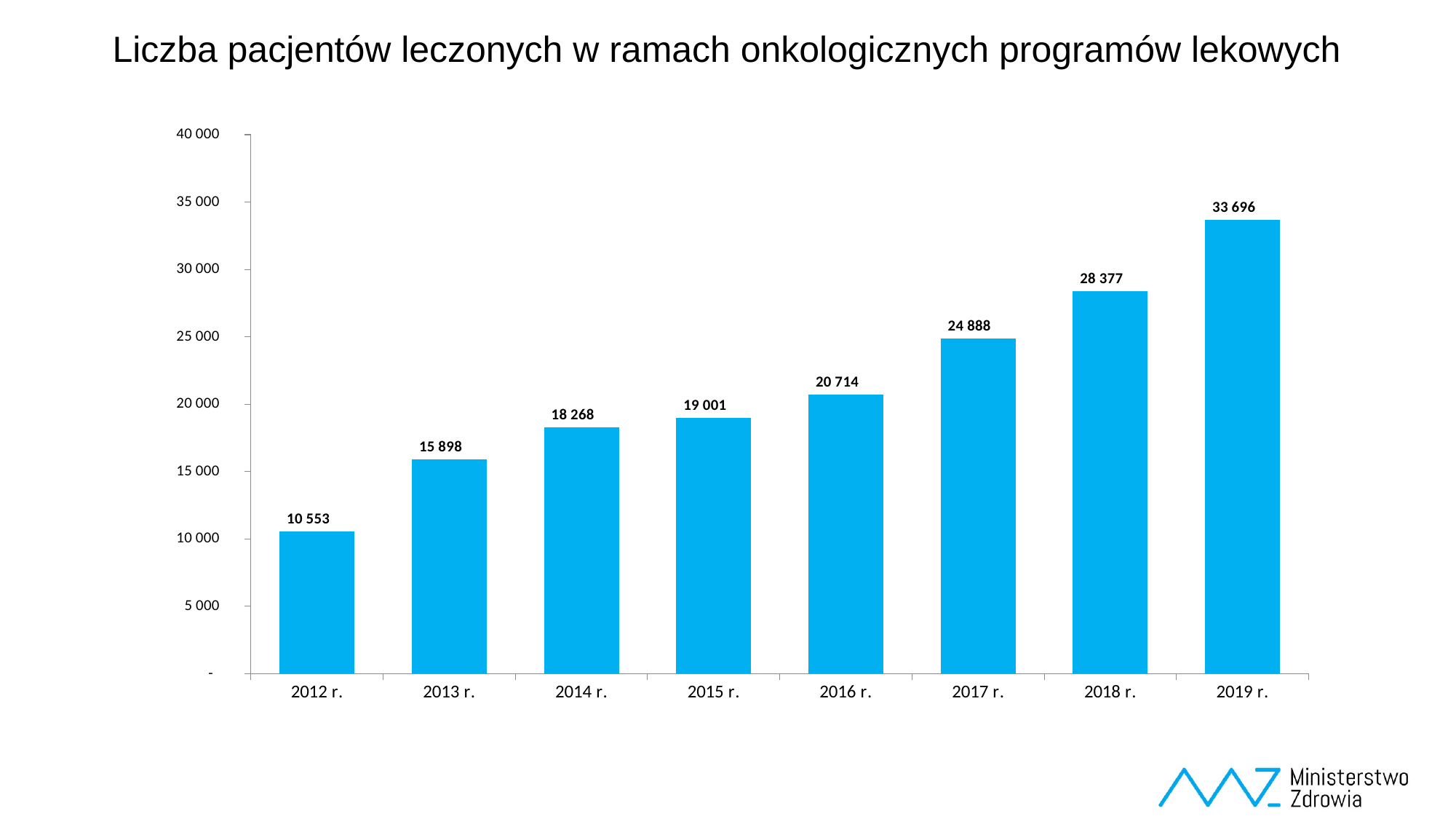
Which is larger, the value for 2015 r. or the value for 2017 r.? 2017 r. What is the difference between the values for 2019 r. and 2018 r.? 5 319 What is the value for 2019 r.? 33 696 What is the value for 2012 r.? 10 553 What is the value for 2016 r.? 20 714 What kind of chart is shown on the slide? bar chart Do the values rise or fall from 2012 r. to 2019 r.? rise How many years are shown on the x axis? 8 Which year has the highest value? 2019 r. Is the value for 2018 r. greater or less than 25 000? greater Which year has the lowest value? 2012 r. What is the difference between the values for 2013 r. and 2012 r.? 5 345